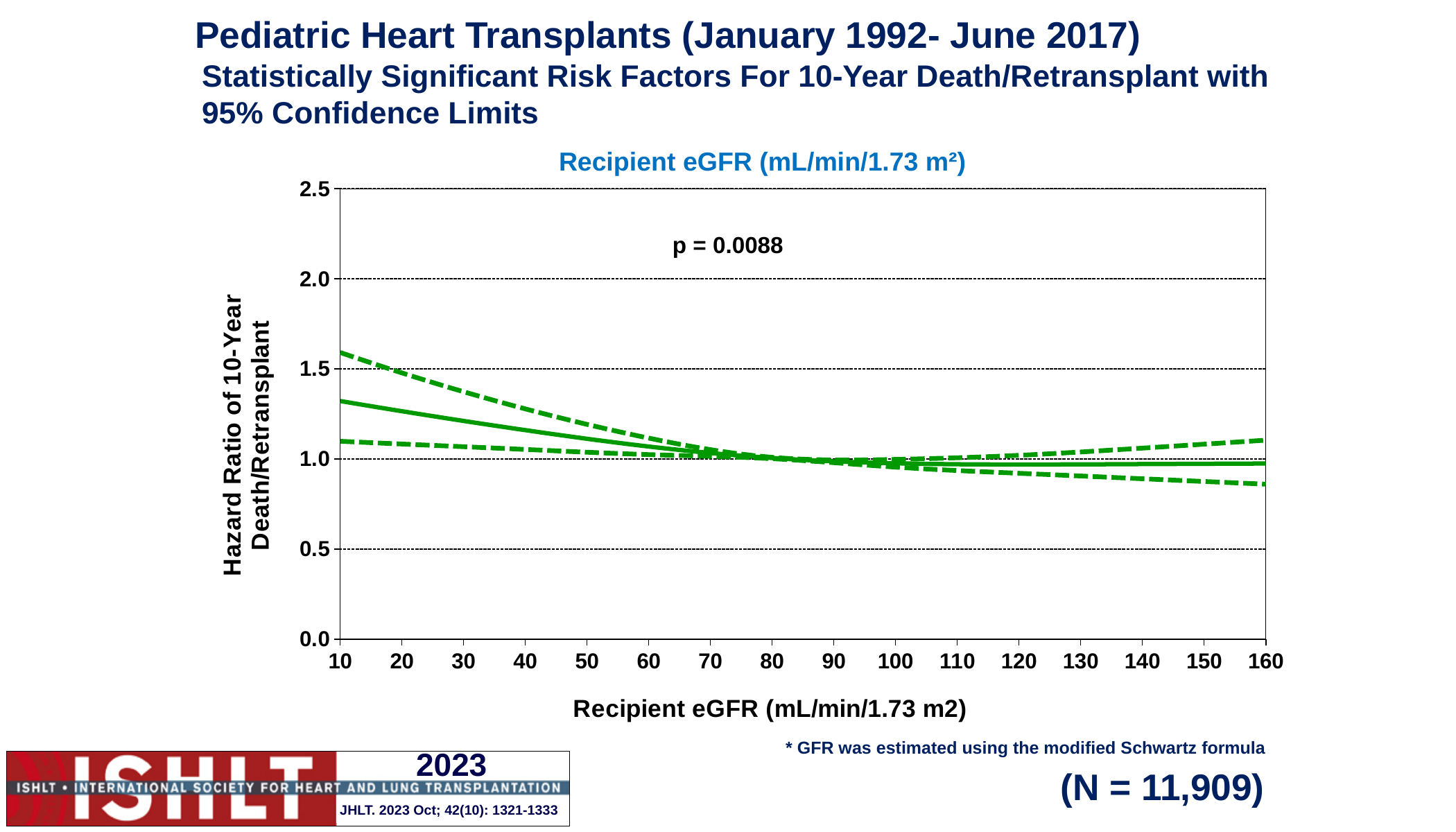
What p-value is printed on the chart? p = 0.0088 Which has the larger hazard ratio on the solid line: a recipient eGFR of 10 or a recipient eGFR of 160? 10 What is the title of the chart? Recipient eGFR (mL/min/1.73 m²) Is the hazard ratio (solid line) at a recipient eGFR of 10 greater or less than 1.5? less Is the upper confidence limit (upper dashed line) at a recipient eGFR of 160 greater or less than 1.0? greater What kind of chart is shown on the slide? line chart Does the solid hazard ratio line rise or fall as recipient eGFR increases from 10 to 160? fall Is the hazard ratio (solid line) at a recipient eGFR of 160 greater or less than 0.5? greater